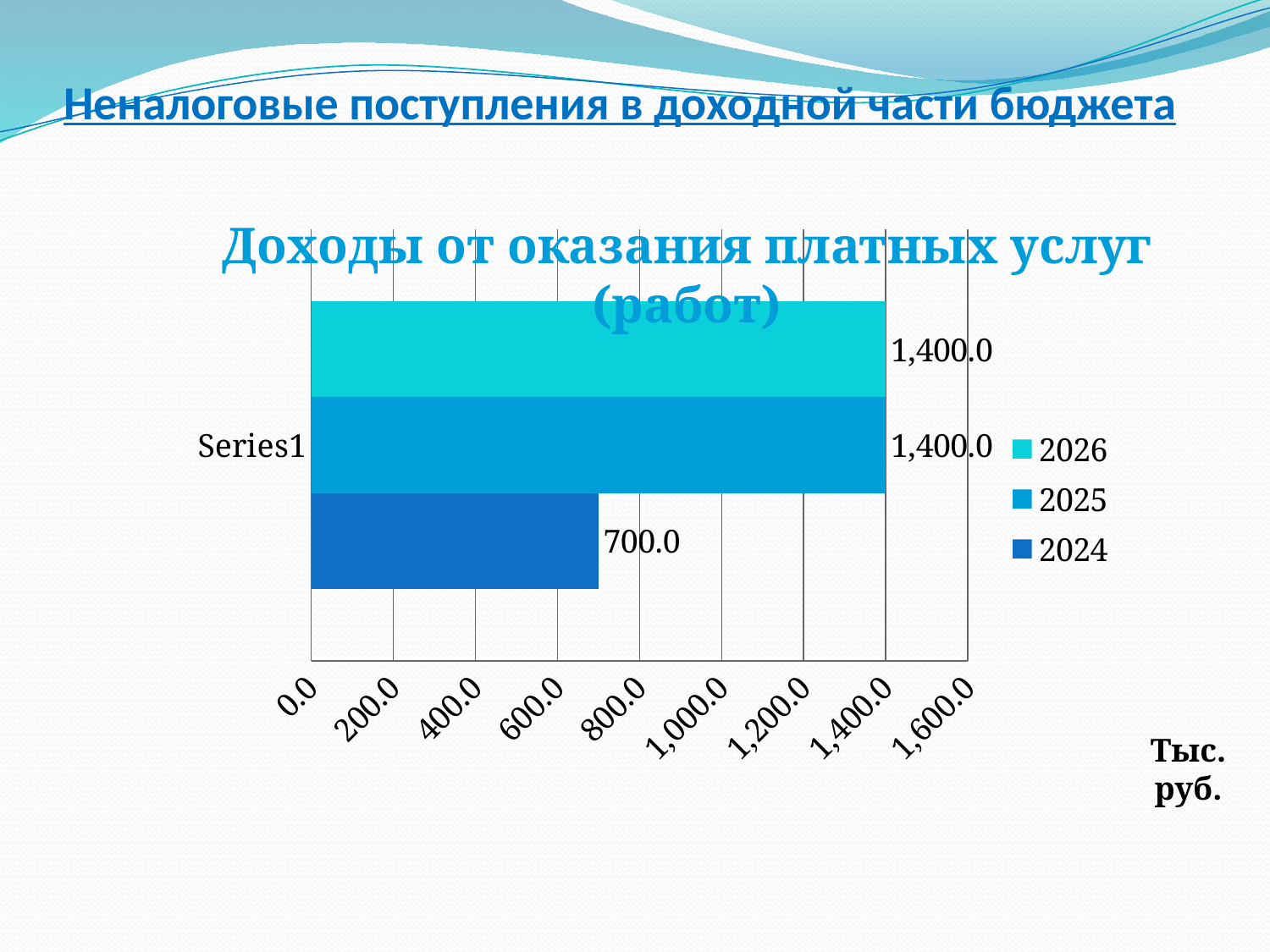
How many series does the legend list? 3 What is the value for 2025 in the chart? 1,400.0 What kind of chart is shown on the slide? bar chart Which year has the lowest value in the chart? 2024 What is the difference between the values for 2025 and 2024? 700.0 What is the title of the chart? Доходы от оказания платных услуг (работ) Is the value for 2026 greater or less than 1,200.0? greater What unit is indicated next to the chart? Тыс. руб. What is the value for 2024 in the chart? 700.0 Is the value for 2024 greater or less than 800.0? less Which is larger, the value for 2026 or the value for 2024? 2026 What is the value for 2026 in the chart? 1,400.0